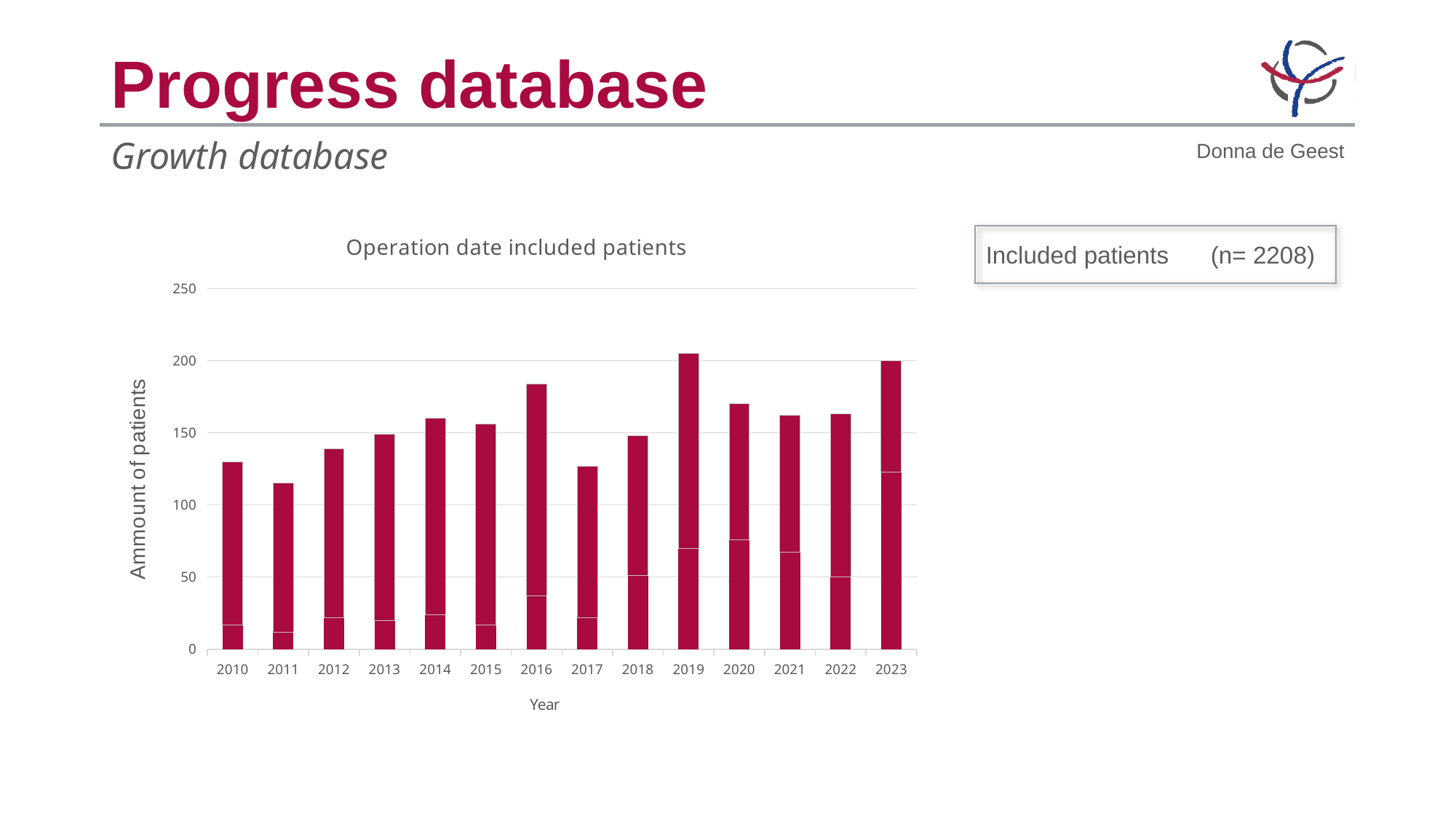
What is the title of the chart? Operation date included patients Do the values rise or fall from 2010 to 2014? rise Which year has the larger value, 2016 or 2017? 2016 What kind of chart is shown on the slide? bar chart Is the value for 2017 greater or less than 150? less Is the value for 2010 greater or less than 100? greater Is the value for 2016 greater or less than 150? greater Which year has the larger value, 2019 or 2010? 2019 Which year has the lowest bar in the chart? 2011 What is the label of the y axis? Ammount of patients How many years are shown on the x axis of the chart? 14